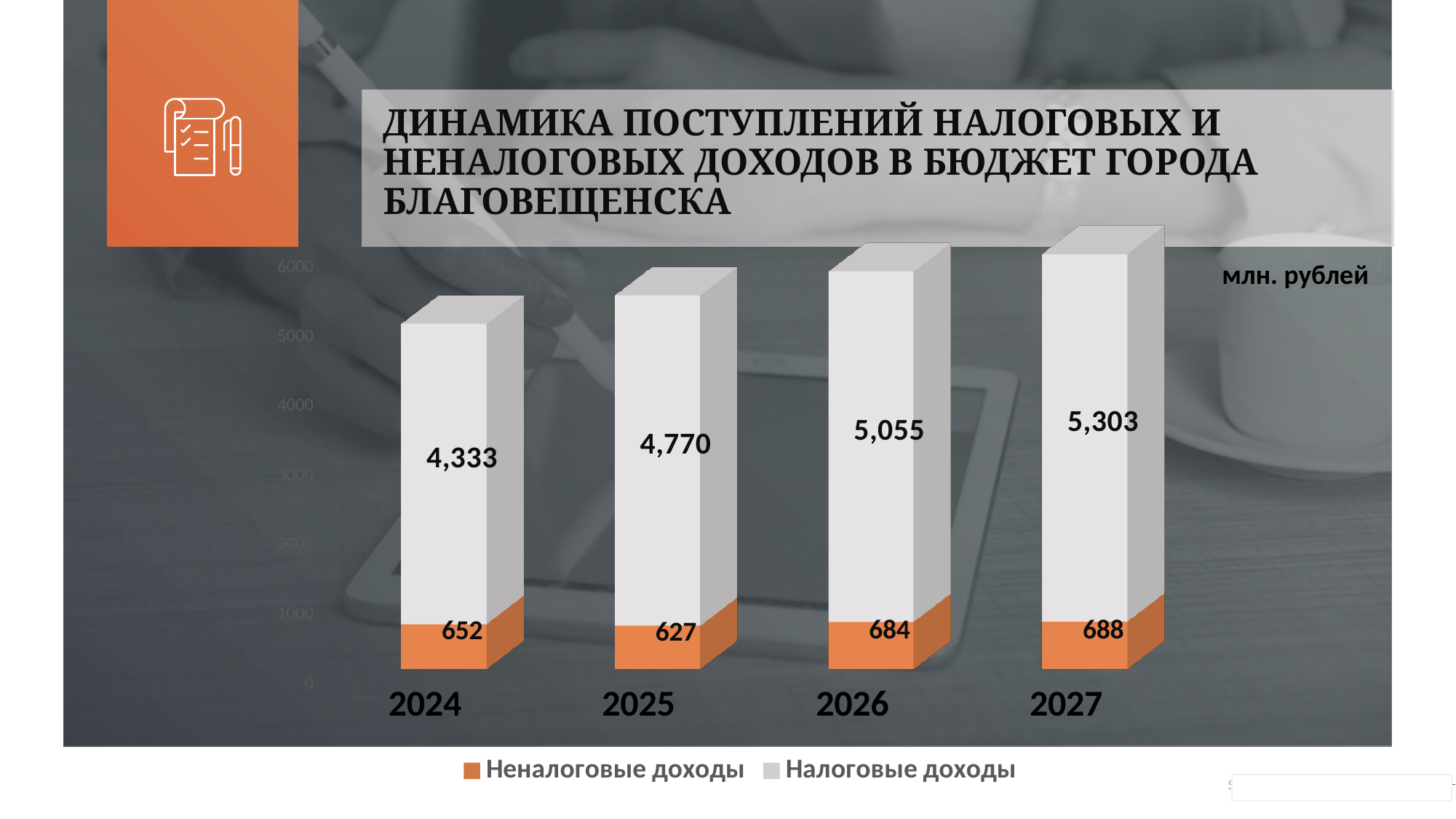
What is the value of Неналоговые доходы for 2026? 684 Which year has the lowest value of Неналоговые доходы? 2025 What is the value of Налоговые доходы for 2024? 4,333 What is the total of the stacked bar for 2026? 5,739 How many years are shown on the x axis? 4 What kind of chart is shown on the slide? Stacked bar chart What is the value of Налоговые доходы for 2027? 5,303 How many series does the legend list? 2 Which is larger: Неналоговые доходы in 2024 or in 2025? 2024 What is the difference between Налоговые доходы in 2027 and in 2024? 970 Do the values of Налоговые доходы rise or fall from 2024 to 2027? Rise Which year has the highest value of Налоговые доходы? 2027